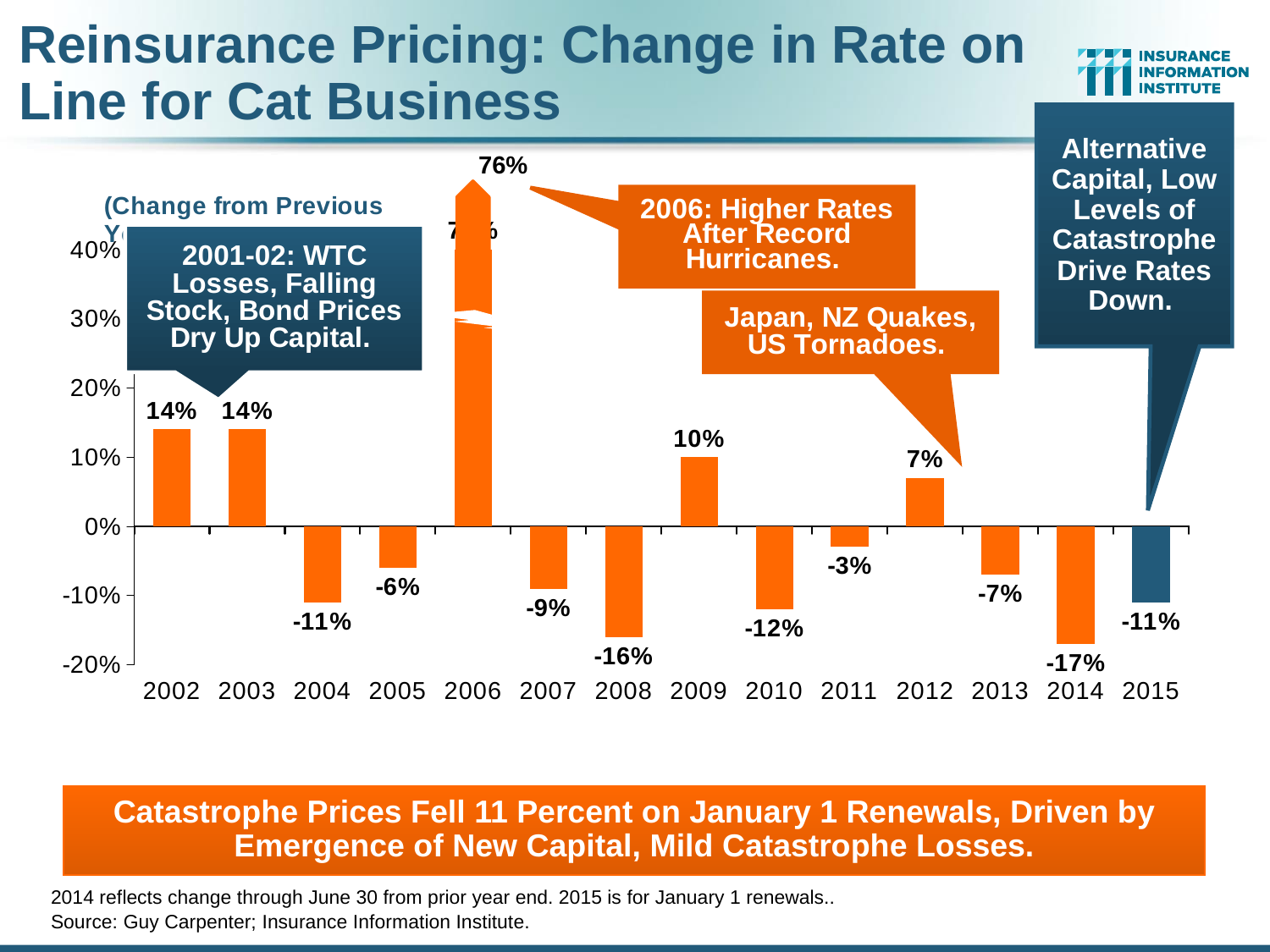
What is the value shown for 2015? -11% Which year has the highest change in rate on line? 2006 How many years are shown on the x axis? 14 Which is larger, the value for 2008 or the value for 2010? 2010 What is the difference between the values for 2009 and 2012? 3% Is the value for 2004 greater or less than -10%? less Which year's bar is shown in a different colour (dark blue) from the others? 2015 What is the value shown for 2014? -17% What is the value shown for 2009? 10% What is the change in rate on line for 2006? 76% What type of chart is shown on the slide? bar chart Which year has the lowest change in rate on line? 2014